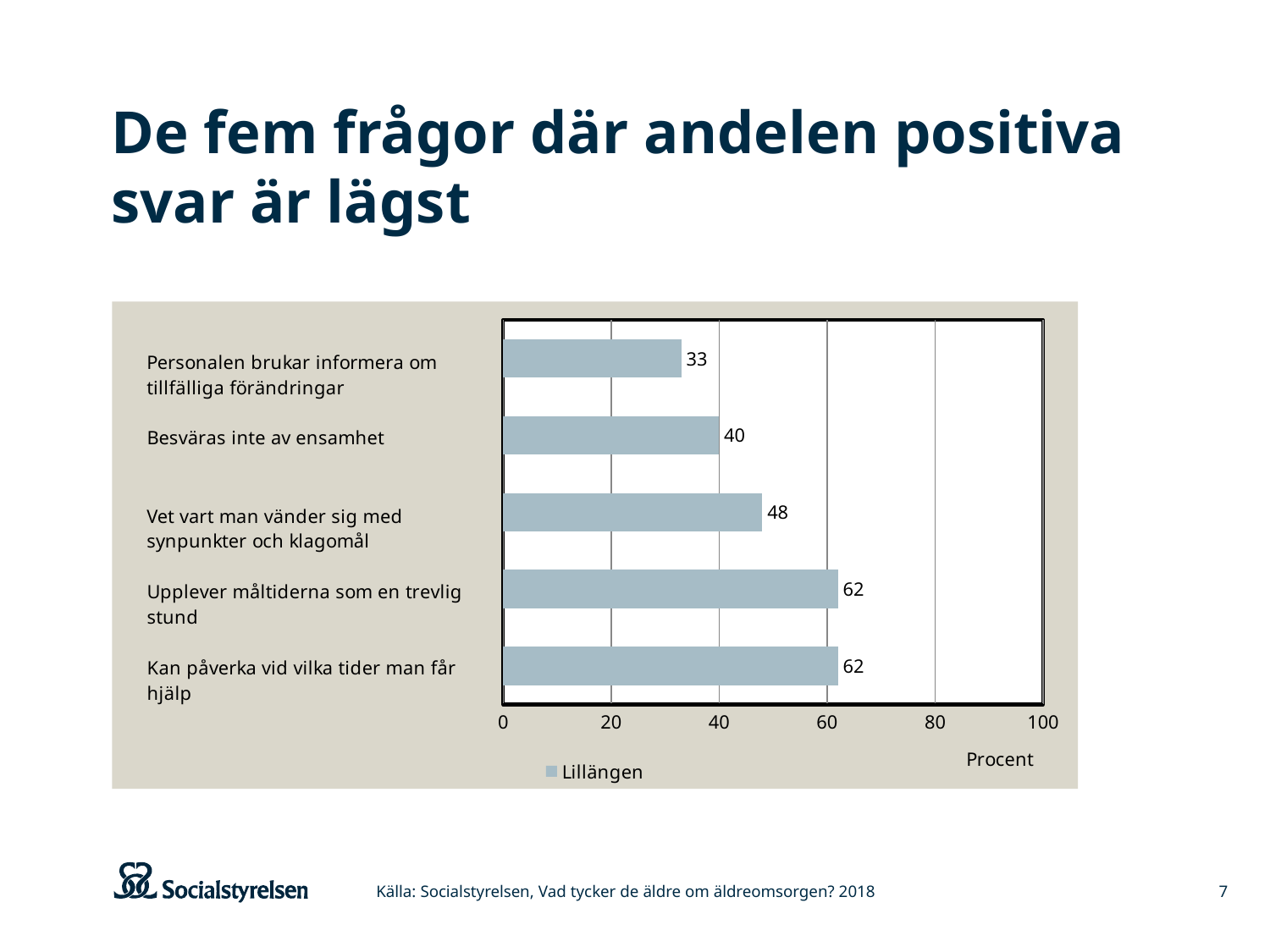
What is the difference between the values for "Upplever måltiderna som en trevlig stund" and "Besväras inte av ensamhet"? 22 What is the value for "Kan påverka vid vilka tider man får hjälp"? 62 Which is larger, the value for "Besväras inte av ensamhet" or the value for "Vet vart man vänder sig med synpunkter och klagomål"? Vet vart man vänder sig med synpunkter och klagomål Which category has the lowest value? Personalen brukar informera om tillfälliga förändringar How many categories are shown in the chart? 5 What kind of chart is shown on the slide? bar chart What is the difference between the values for "Vet vart man vänder sig med synpunkter och klagomål" and "Personalen brukar informera om tillfälliga förändringar"? 15 Is the value for "Upplever måltiderna som en trevlig stund" greater or less than 60? greater What is the value for "Vet vart man vänder sig med synpunkter och klagomål"? 48 What is the value for "Besväras inte av ensamhet"? 40 What is the value for "Personalen brukar informera om tillfälliga förändringar"? 33 What series name does the legend show? Lillängen